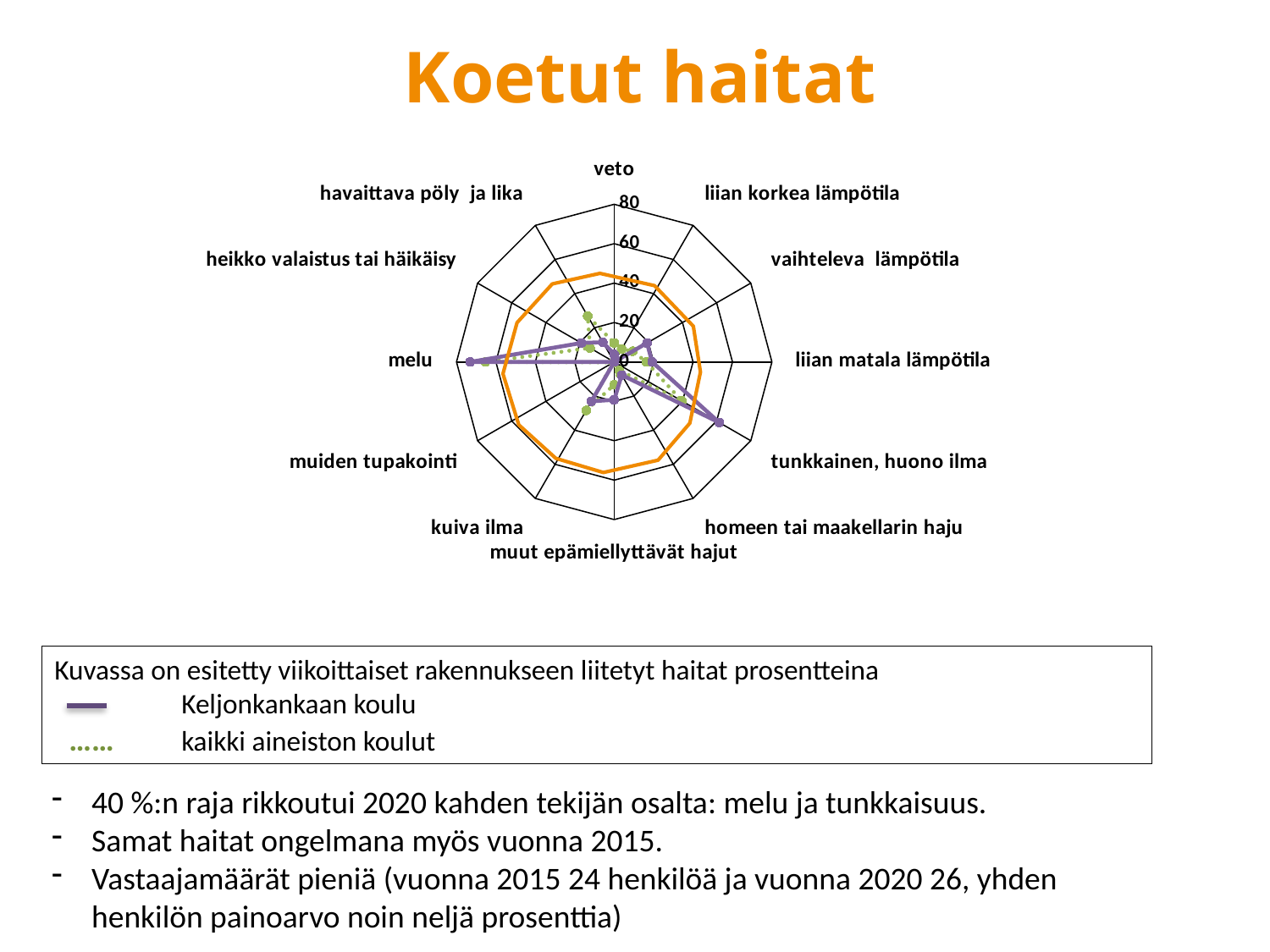
Is the value for melu for Keljonkankaan koulu greater or less than 60? greater For Keljonkankaan koulu, which is larger: melu or tunkkainen, huono ilma? melu What kind of chart is shown on the slide? radar chart Is the value for veto for Keljonkankaan koulu greater or less than 20? less How many categories (axes) does the radar chart have? 12 Which category has the highest value for Keljonkankaan koulu? melu Is the value for liian korkea lämpötila for Keljonkankaan koulu greater or less than 20? less What is the highest value shown on the chart's axis scale? 80 Which series is drawn with a green dotted line? kaikki aineiston koulut How many series does the legend below the chart list? 2